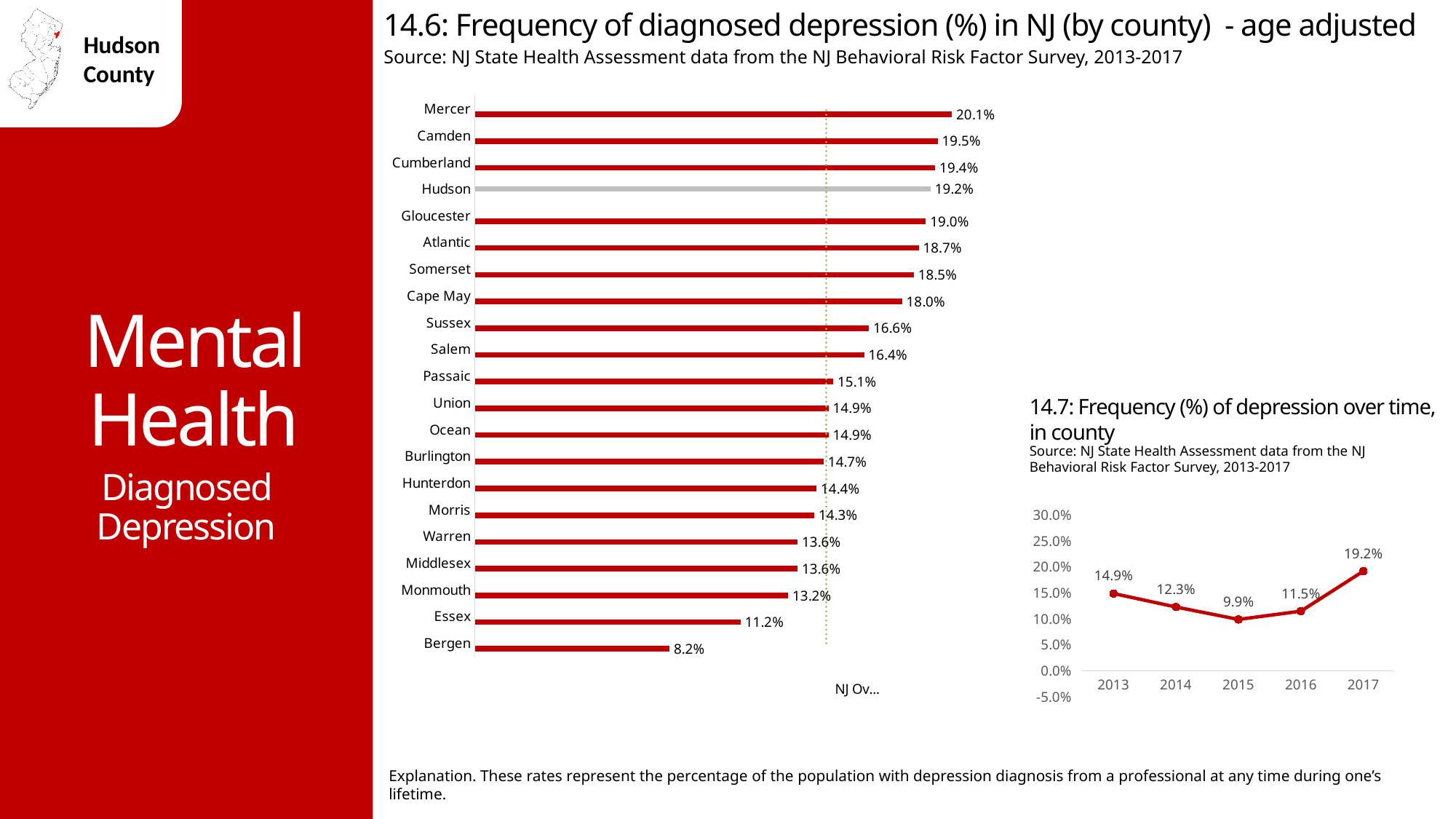
In chart 14.6, what is the frequency of diagnosed depression for Hudson County? 19.2% In chart 14.6, which county has the highest frequency of diagnosed depression? Mercer What kind of chart is chart 14.6? Bar chart In chart 14.7, which year has the highest frequency of depression? 2017 What kind of chart is chart 14.7? Line chart In chart 14.7, what is the frequency of depression in 2015? 9.9% In chart 14.6, what is the value for Passaic? 15.1% In chart 14.6, which county has a higher value, Camden or Essex? Camden In chart 14.7, what is the difference between the 2017 value and the 2013 value? 4.3% In chart 14.6, which county has the lowest frequency of diagnosed depression? Bergen In chart 14.6, how many counties are shown? 21 In chart 14.6, what is the difference between Mercer's value and Bergen's value? 11.9%